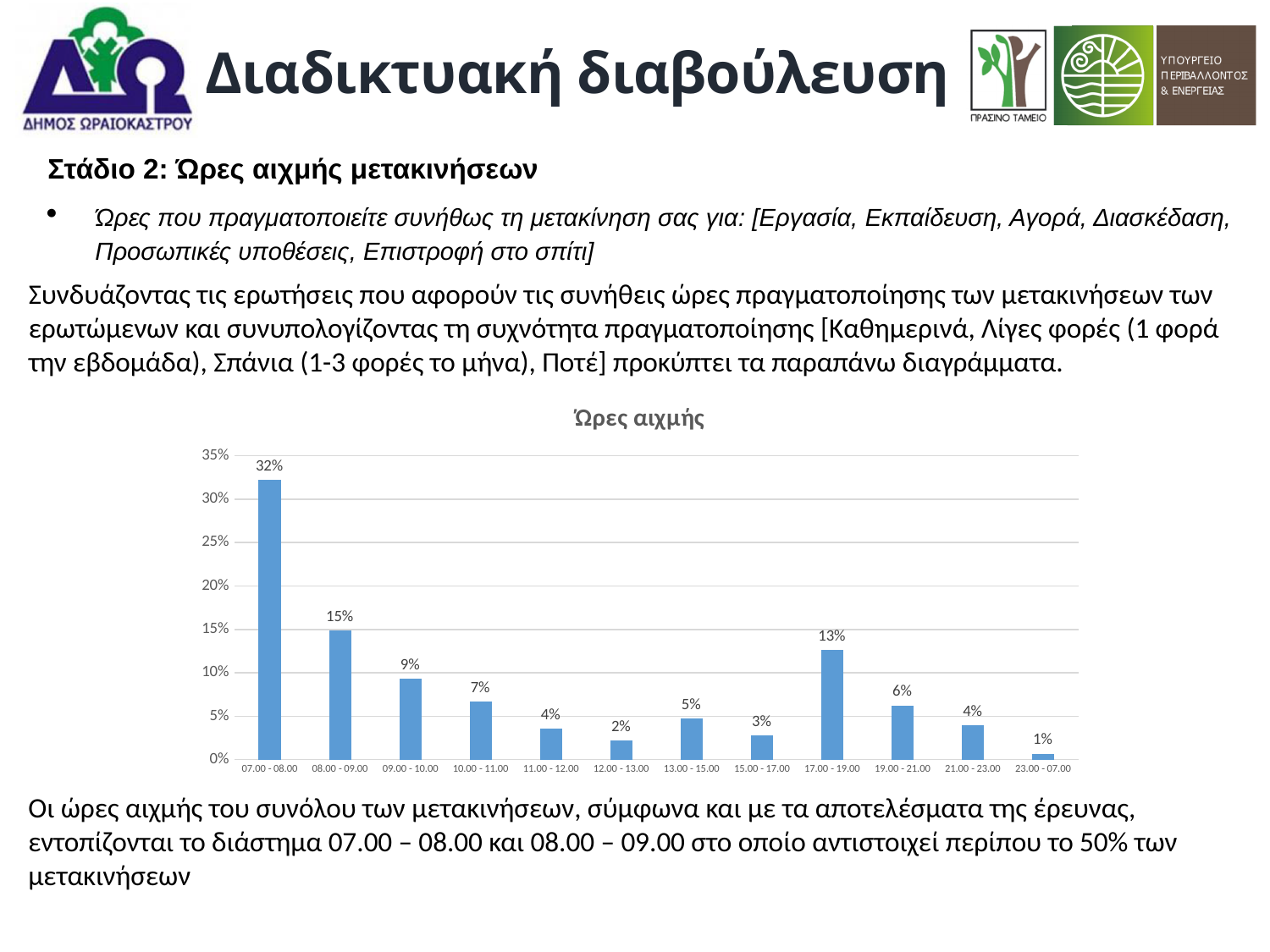
What is the difference between the values for 07.00 - 08.00 and 08.00 - 09.00? 17% What is the value for the 17.00 - 19.00 time slot? 13% What is the value for the 12.00 - 13.00 time slot? 2% What is the title of the chart? Ώρες αιχμής What kind of chart is shown on the slide? Bar chart Which time slot has the highest value in the chart? 07.00 - 08.00 Which is larger, the value for 09.00 - 10.00 or the value for 17.00 - 19.00? 17.00 - 19.00 Which time slot has the lowest value in the chart? 23.00 - 07.00 Is the value for 08.00 - 09.00 greater or less than 10%? greater Do the values rise or fall from 07.00 - 08.00 to 12.00 - 13.00? Fall What is the value for the 07.00 - 08.00 time slot in the Ώρες αιχμής chart? 32% How many time slots are shown on the x axis of the chart? 12